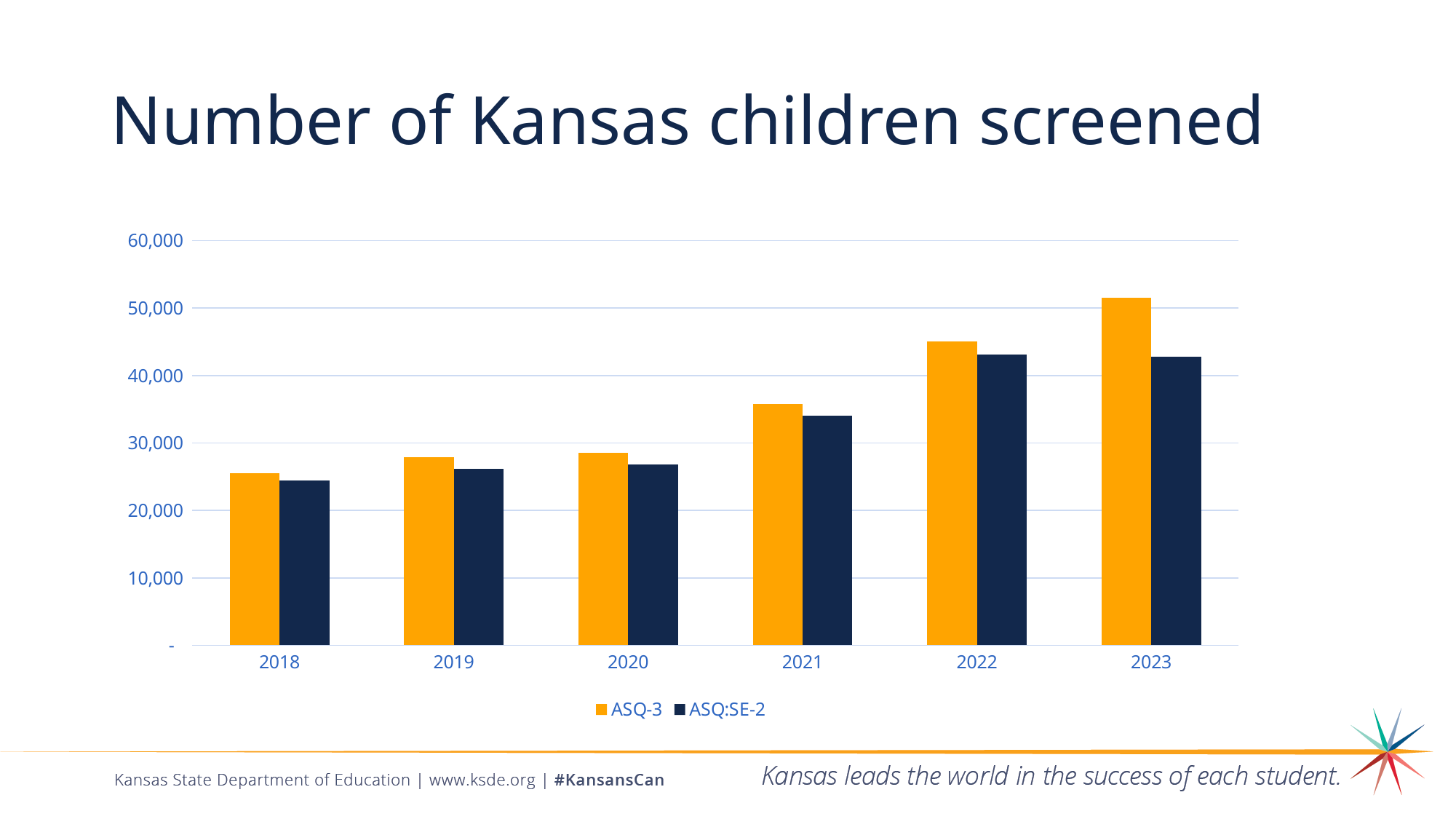
Is the ASQ:SE-2 value for 2021 greater or less than 40,000? less Is the ASQ-3 value for 2023 greater or less than 50,000? greater How many years are shown on the x axis? 6 Which year has the lowest ASQ:SE-2 value? 2018 What type of chart is shown on the slide? Bar chart What colour are the ASQ-3 bars? Orange Which year has the lowest ASQ-3 value? 2018 In 2022, which series has the larger value, ASQ-3 or ASQ:SE-2? ASQ-3 How many series does the legend list? 2 Is the ASQ-3 value for 2018 greater or less than 30,000? less Which year has the highest ASQ-3 value? 2023 Do the ASQ-3 values rise or fall from 2018 to 2023? Rise